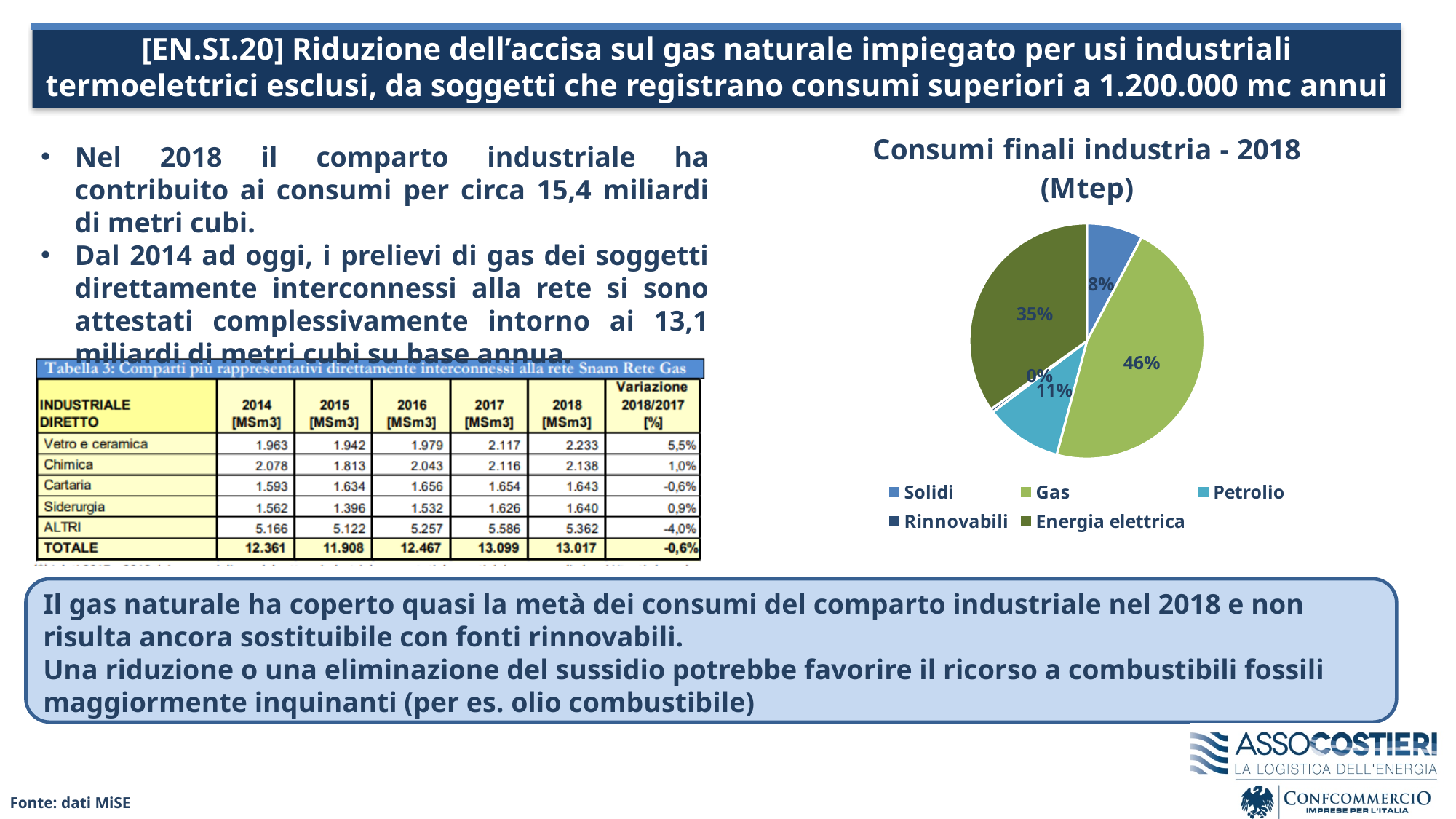
What is the title of the pie chart on the slide? Consumi finali industria - 2018 (Mtep) How many categories does the legend of the pie chart 'Consumi finali industria - 2018 (Mtep)' list? 5 In the pie chart 'Consumi finali industria - 2018 (Mtep)', what share does Petrolio have? 11% In the pie chart 'Consumi finali industria - 2018 (Mtep)', which is larger, the share of Petrolio or the share of Solidi? Petrolio In the pie chart 'Consumi finali industria - 2018 (Mtep)', which category has the largest share? Gas In the pie chart 'Consumi finali industria - 2018 (Mtep)', how many percentage points larger is the Gas share than the Energia elettrica share? 11 In the pie chart 'Consumi finali industria - 2018 (Mtep)', what share does Energia elettrica have? 35% In the pie chart 'Consumi finali industria - 2018 (Mtep)', what share does Solidi have? 8% In the pie chart 'Consumi finali industria - 2018 (Mtep)', which category has the smallest share? Rinnovabili What kind of chart is 'Consumi finali industria - 2018 (Mtep)'? pie chart